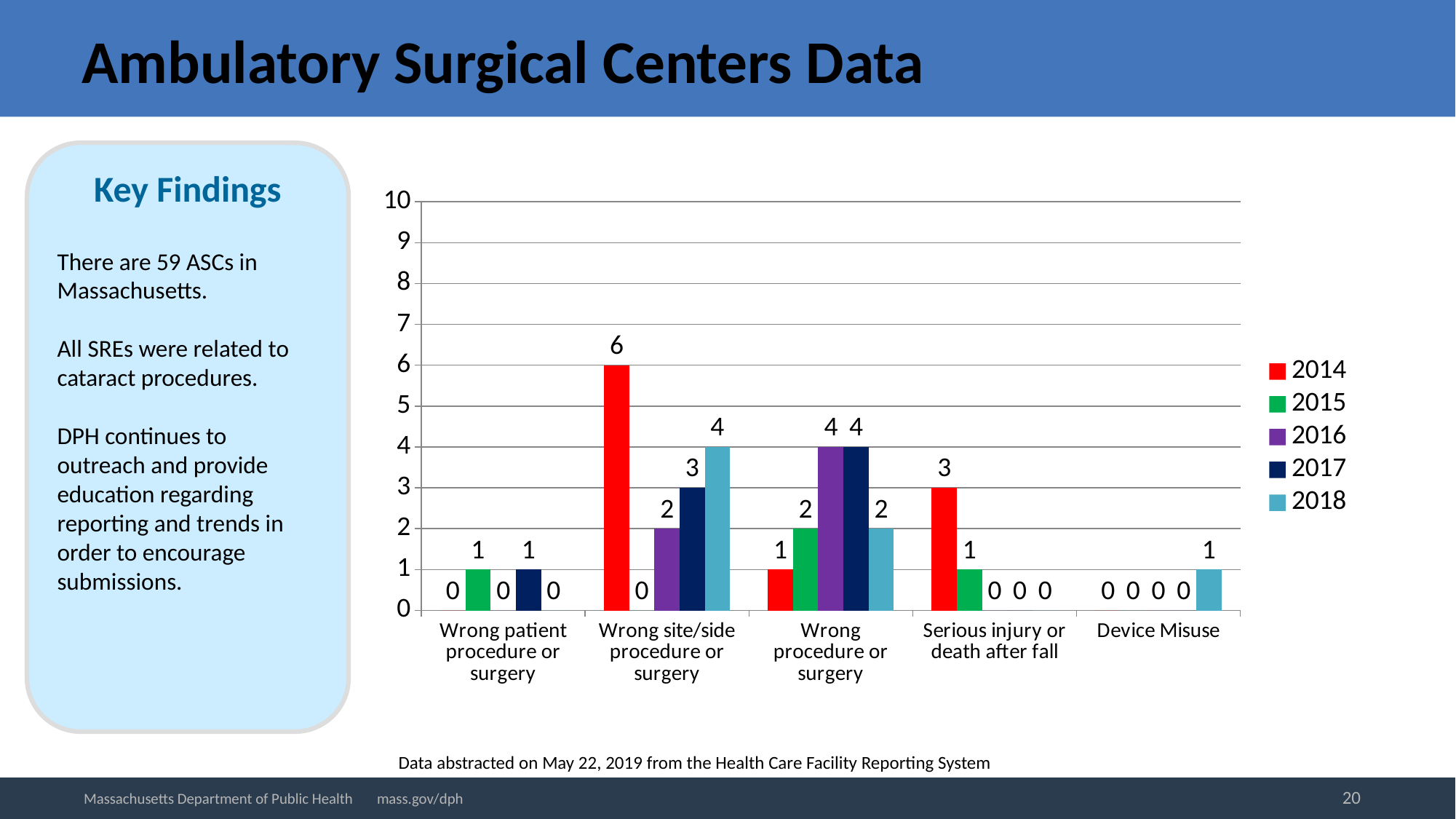
Which is larger in the Wrong procedure or surgery category, the 2016 value or the 2018 value? 2016 What is the difference between the 2014 and 2018 values in the Wrong site/side procedure or surgery category? 2 How many categories are shown on the x axis? 5 Which colour represents 2014 in the legend? Red What is the value for 2018 in the Device Misuse category? 1 How many series does the legend list? 5 Which year has the highest value in the Wrong site/side procedure or surgery category? 2014 Which year has the lowest value in the Wrong site/side procedure or surgery category? 2015 What kind of chart is shown on the slide? Bar chart What is the value for 2015 in the Serious injury or death after fall category? 1 What is the value for 2014 in the Wrong site/side procedure or surgery category? 6 What is the value for 2017 in the Wrong procedure or surgery category? 4